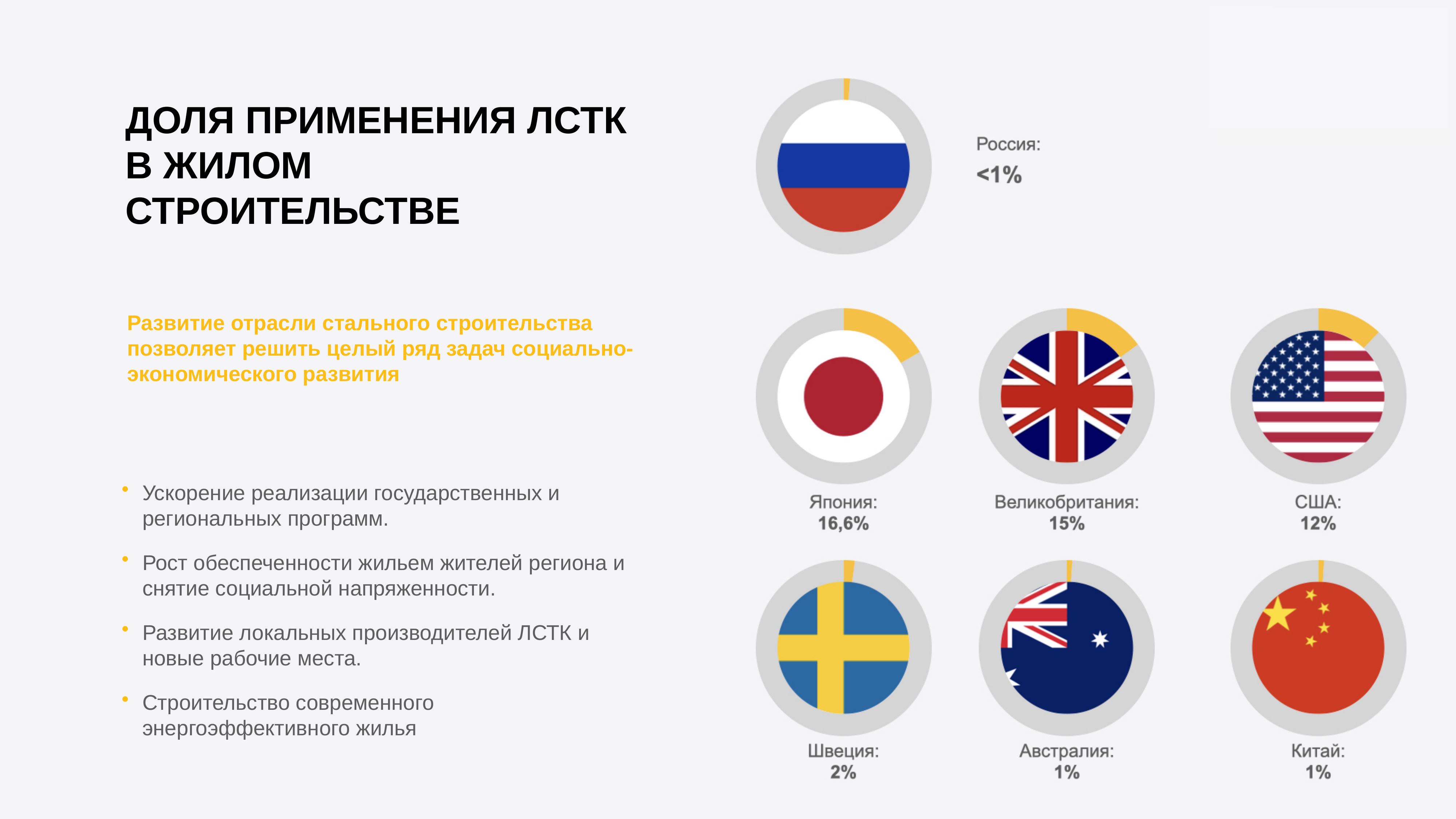
What value is shown for Россия (Russia)? <1% What value is shown for США (USA)? 12% What is the title of the slide containing the charts? ДОЛЯ ПРИМЕНЕНИЯ ЛСТК В ЖИЛОМ СТРОИТЕЛЬСТВЕ Which country has the lowest share shown on the slide? Россия (<1%) How many countries are shown with ring charts on the slide? 7 Which is larger, the value for Швеция or the value for Австралия? Швеция What share of LSTK use in residential construction is shown for Япония (Japan)? 16,6% What value is shown for Швеция (Sweden)? 2% What value is shown for Великобритания (United Kingdom)? 15% What is the difference between the values for Великобритания and США? 3% What is the difference between the values for Япония and Великобритания? 1,6% Which country has the highest share shown on the slide? Япония (16,6%)